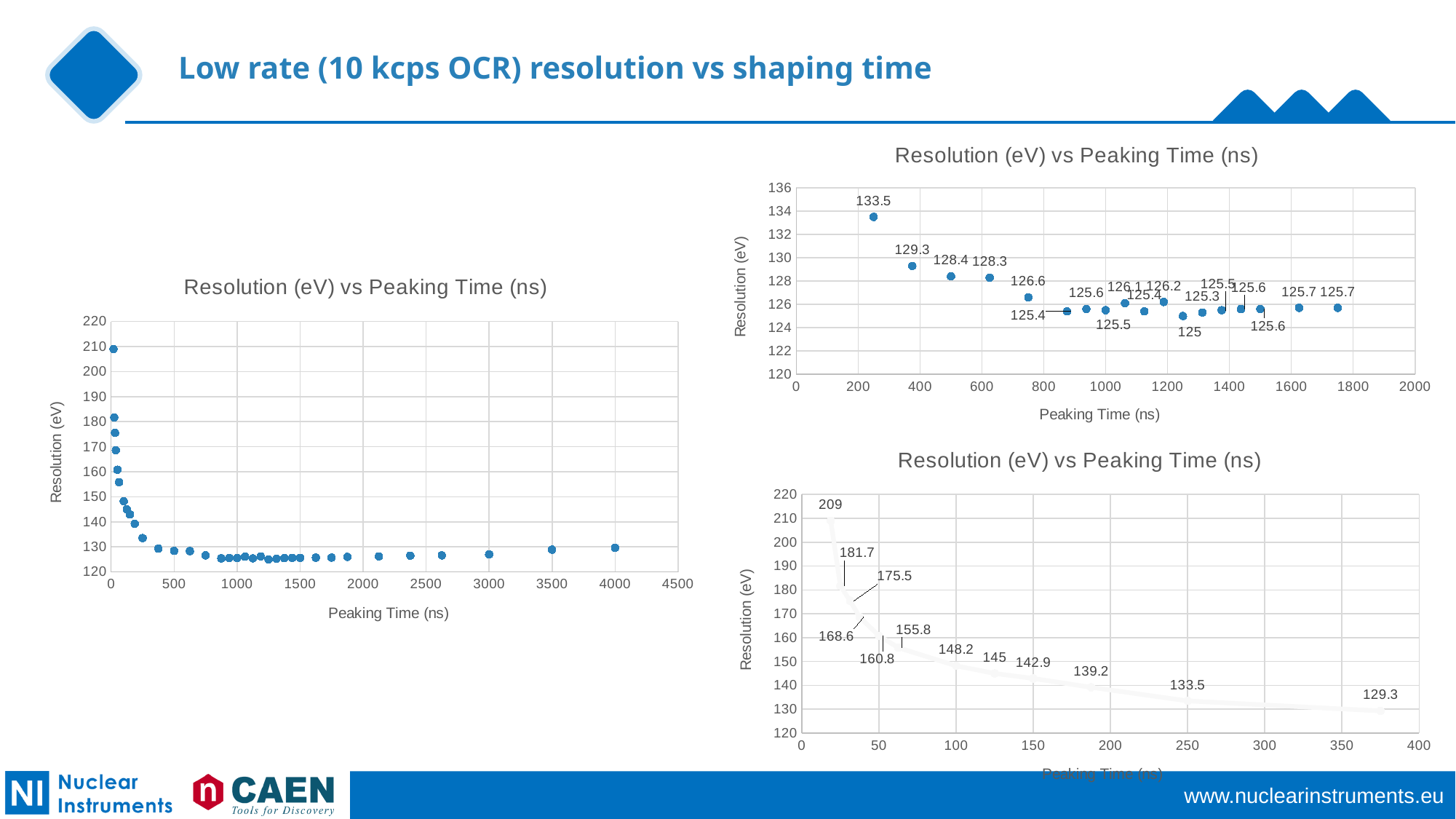
What is the x-axis title of the left chart? Peaking Time (ns) In the bottom-right chart, what is the difference between the highest labelled value (209) and the lowest labelled value (129.3)? 79.7 In the top-right chart, which is larger: the first point (at about 250 ns) or the last point (at about 1750 ns)? the first point (133.5) In the bottom-right chart, what is the highest labelled resolution value? 209 How many labelled data points are in the bottom-right chart? 12 In the top-right chart, what is the lowest labelled resolution value? 125 In the bottom-right chart, what is the lowest labelled resolution value? 129.3 In the bottom-right chart, do the resolution values rise or fall as peaking time increases? fall In the left chart, is the resolution value at a peaking time of 4000 ns greater or less than 140? less In the top-right chart, what is the highest labelled resolution value? 133.5 What kind of chart is the top-right chart? scatter chart In the top-right chart, what is the difference between the two highest labelled values, 133.5 and 129.3? 4.2